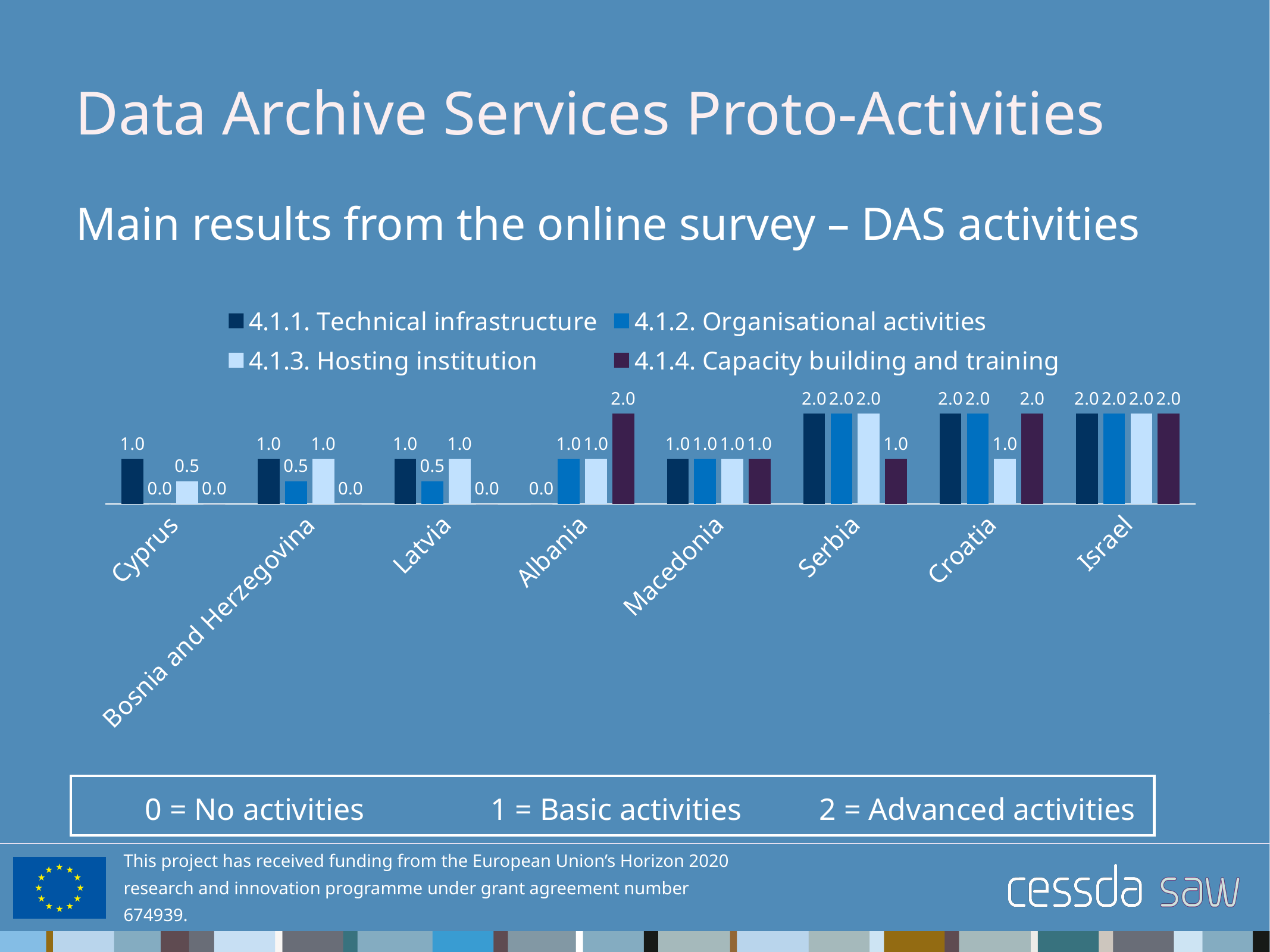
What is the value for 4.1.3. Hosting institution for Cyprus? 0.5 What is the value for 4.1.4. Capacity building and training for Albania? 2.0 Which is larger for Croatia: 4.1.3. Hosting institution or 4.1.4. Capacity building and training? 4.1.4. Capacity building and training Which legend entry is shown in dark purple? 4.1.4. Capacity building and training What is the difference between the 4.1.1. Technical infrastructure value for Israel and the 4.1.1. Technical infrastructure value for Cyprus? 1.0 Which country has the lowest value for 4.1.1. Technical infrastructure? Albania How many countries are shown on the x axis? 8 How many series does the legend list? 4 What is the value for 4.1.1. Technical infrastructure for Albania? 0.0 What is the value for 4.1.4. Capacity building and training for Serbia? 1.0 What type of chart is shown on the slide? bar chart Which country has all four series at 2.0? Israel